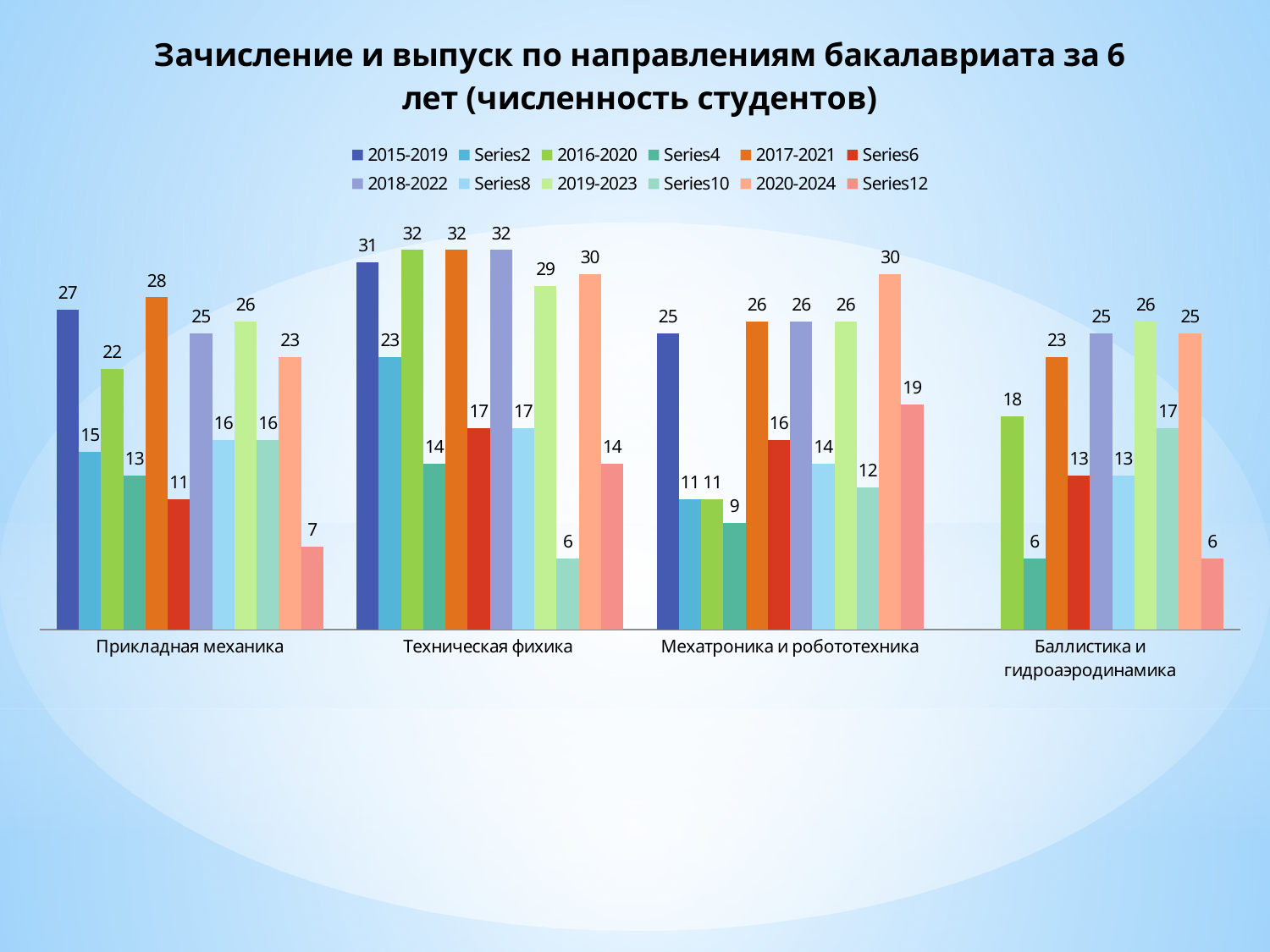
What is the value of the 2017-2021 series for Баллистика и гидроаэродинамика? 23 How many series does the legend list? 12 How many categories are shown on the x axis? 4 What is the value of the 2019-2023 series for Техническая фихика? 29 What is the value of the 2020-2024 series for Мехатроника и робототехника? 30 What is the value of the 2015-2019 series for Прикладная механика? 27 What is the title of the chart? Зачисление и выпуск по направлениям бакалавриата за 6 лет (численность студентов) What kind of chart is shown on the slide? bar chart What is the difference between the 2017-2021 value and the Series6 value for Техническая фихика? 15 Which category has the lowest value for the Series12 series? Баллистика и гидроаэродинамика Which is larger: the 2018-2022 value for Прикладная механика or for Мехатроника и робототехника? Мехатроника и робототехника Which category has the highest value for the 2015-2019 series? Техническая фихика